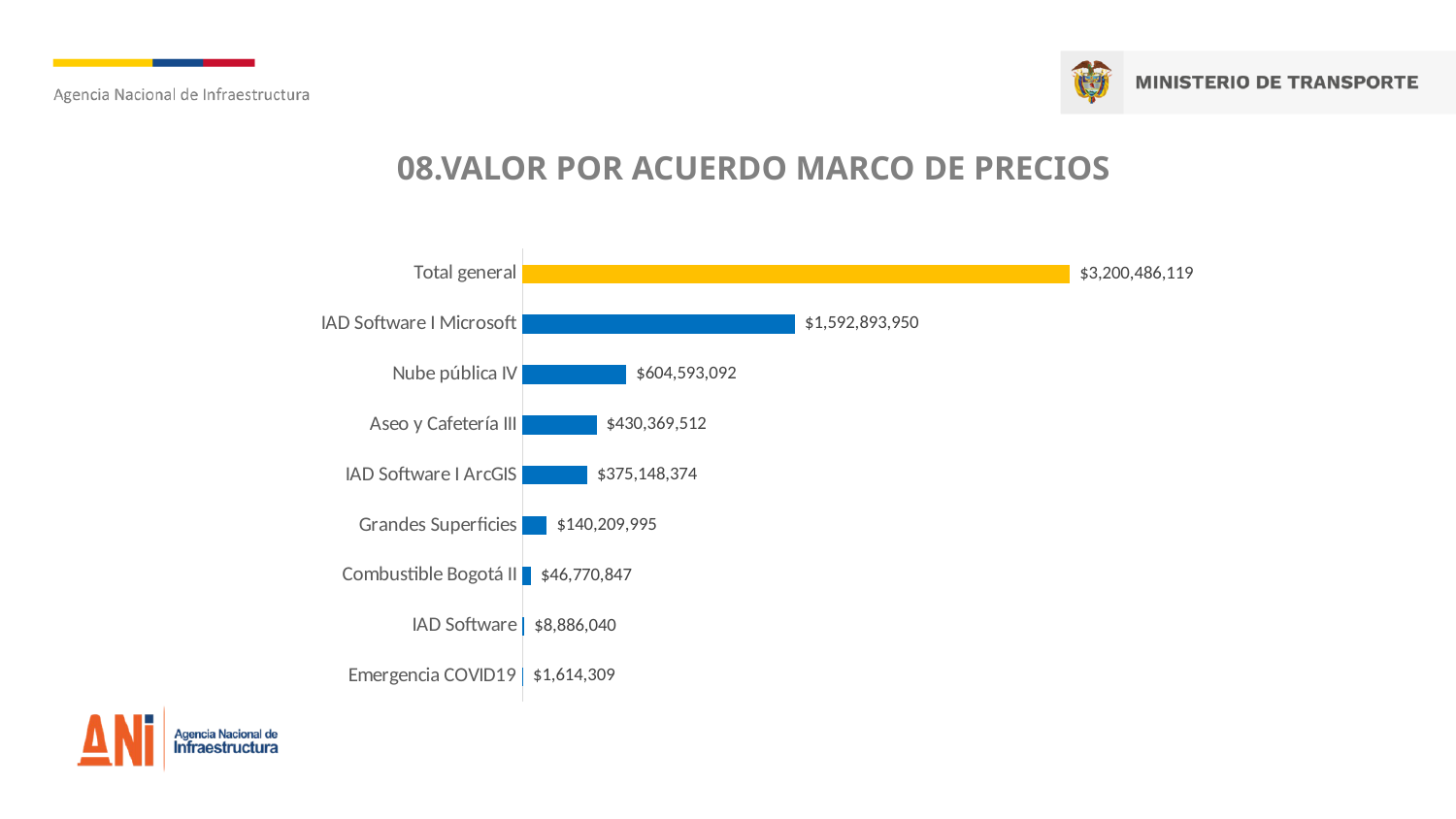
What type of chart is shown on the slide? Bar chart What is the value shown for Total general? $3,200,486,119 Excluding the Total general bar, which category has the highest value? IAD Software I Microsoft What is the value for Emergencia COVID19? $1,614,309 What is the value for Grandes Superficies? $140,209,995 What is the value for IAD Software I Microsoft? $1,592,893,950 Which category has the lowest value? Emergencia COVID19 How many bars are shown in the chart, including Total general? 9 What is the difference between IAD Software I Microsoft and Nube pública IV? $988,300,858 What is the value for Nube pública IV? $604,593,092 What is the difference between Aseo y Cafetería III and IAD Software I ArcGIS? $55,221,138 Which is larger, Combustible Bogotá II or IAD Software? Combustible Bogotá II